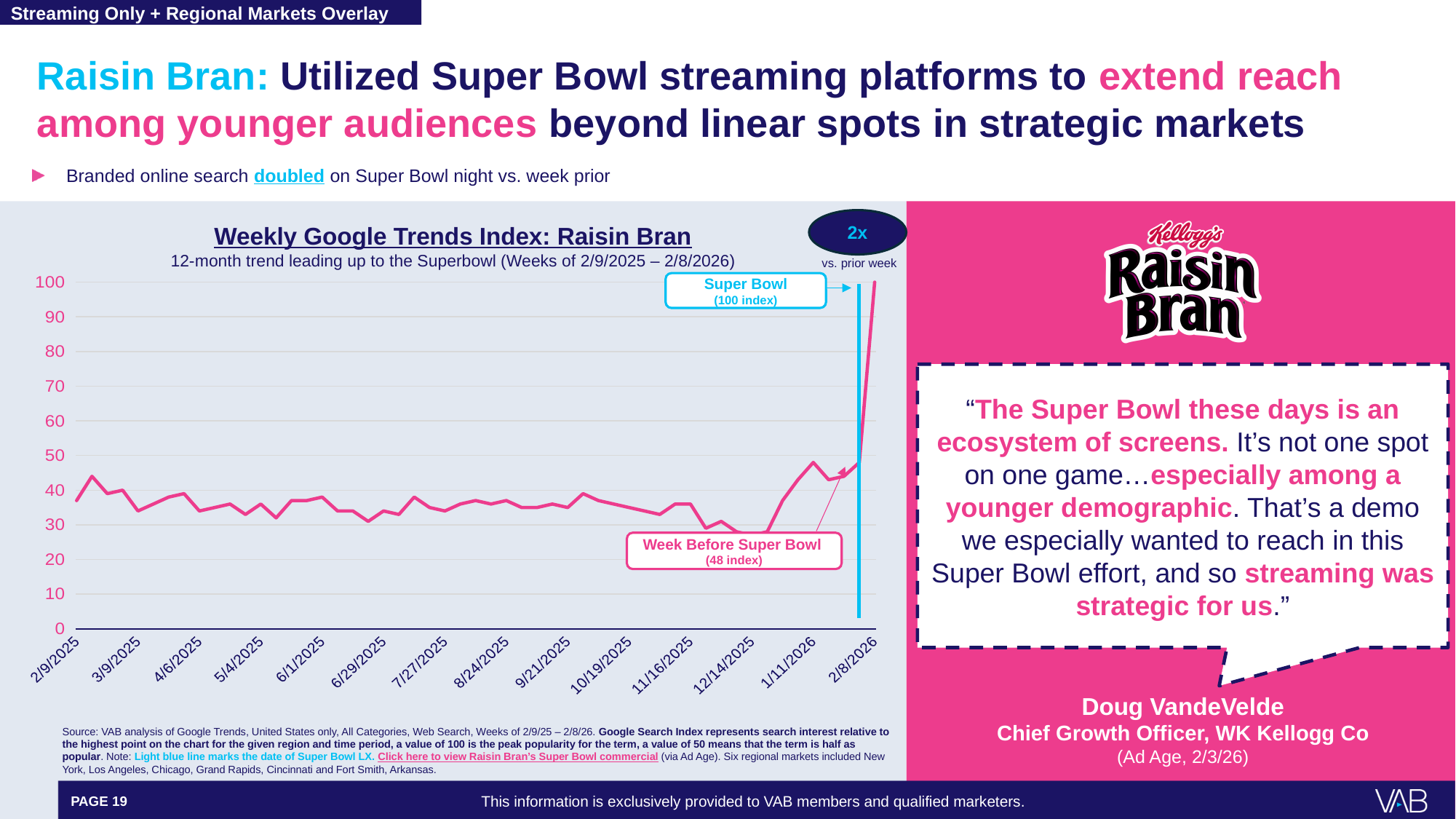
What is the Google Trends index value for the week before the Super Bowl? 48 What is the difference between the Super Bowl week index and the week-before index? 52 What kind of chart is shown on the slide? line chart How many week labels are shown on the x axis? 14 According to the callout above the chart, by what multiple did the index change versus the prior week? 2x What is the Google Trends index value for the Super Bowl week? 100 Is the index value for the week of 2/9/2025 greater or less than 30? greater Which is larger, the index for the Super Bowl week or the index for the week before the Super Bowl? Super Bowl week Which week has the highest index value on the chart? 2/8/2026 (Super Bowl week) Does the index rise or fall between 1/11/2026 and 2/8/2026? rise Is the index value for the week of 6/29/2025 greater or less than 50? less What is the title of the chart? Weekly Google Trends Index: Raisin Bran